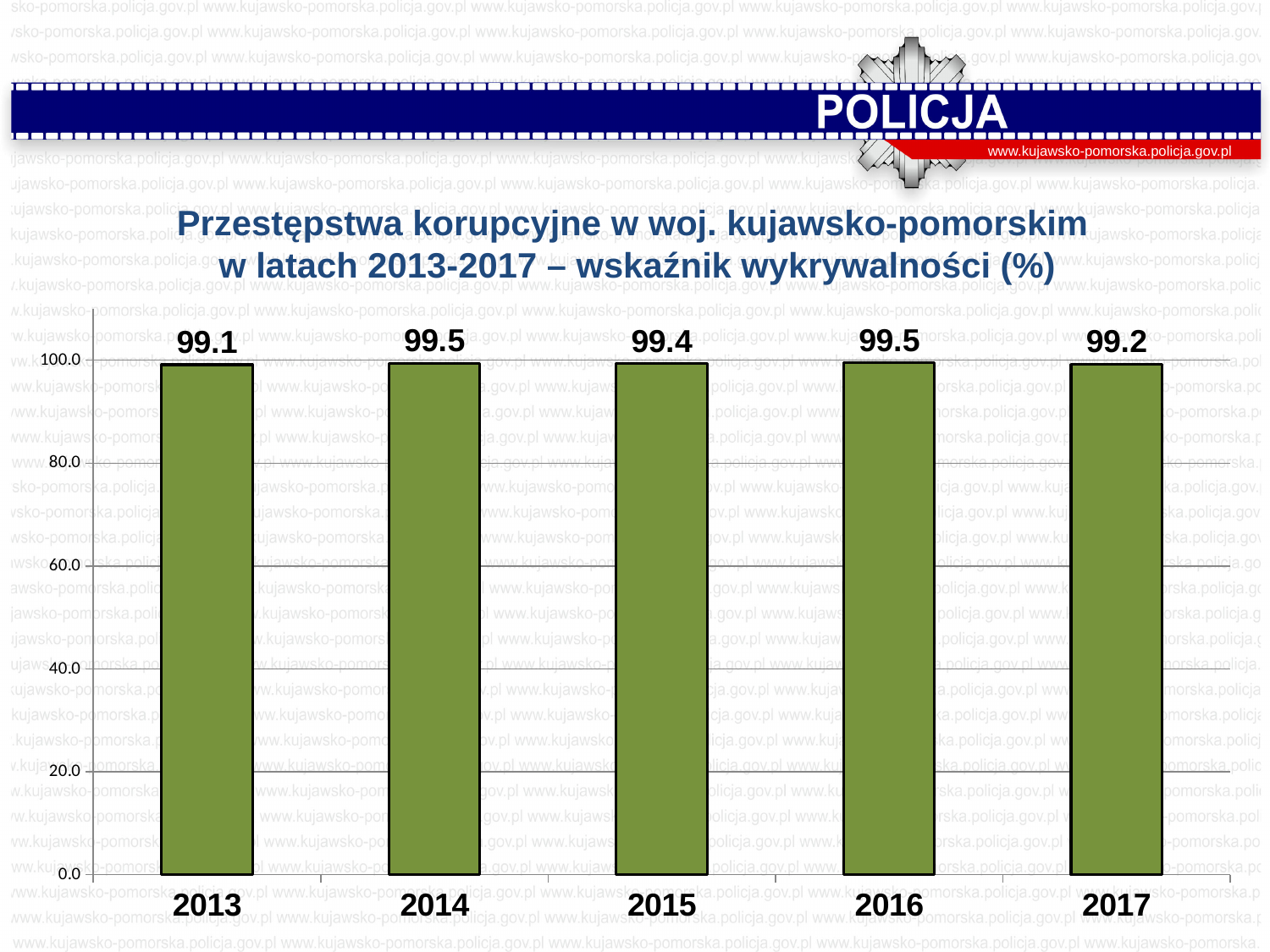
What is the detection rate shown for 2013? 99.1 How many years are shown on the x axis of the chart? 5 What is the detection rate shown for 2016? 99.5 Which year has the higher detection rate, 2013 or 2014? 2014 What is the difference between the detection rate in 2016 and in 2017? 0.3 What is the detection rate shown for 2015? 99.4 What is the detection rate shown for 2017? 99.2 Which year has the lowest detection rate? 2013 Which year has the higher detection rate, 2015 or 2017? 2015 Is the value for 2015 greater or less than 80.0? greater What is the difference between the detection rate in 2014 and in 2013? 0.4 What kind of chart is shown on the slide? bar chart